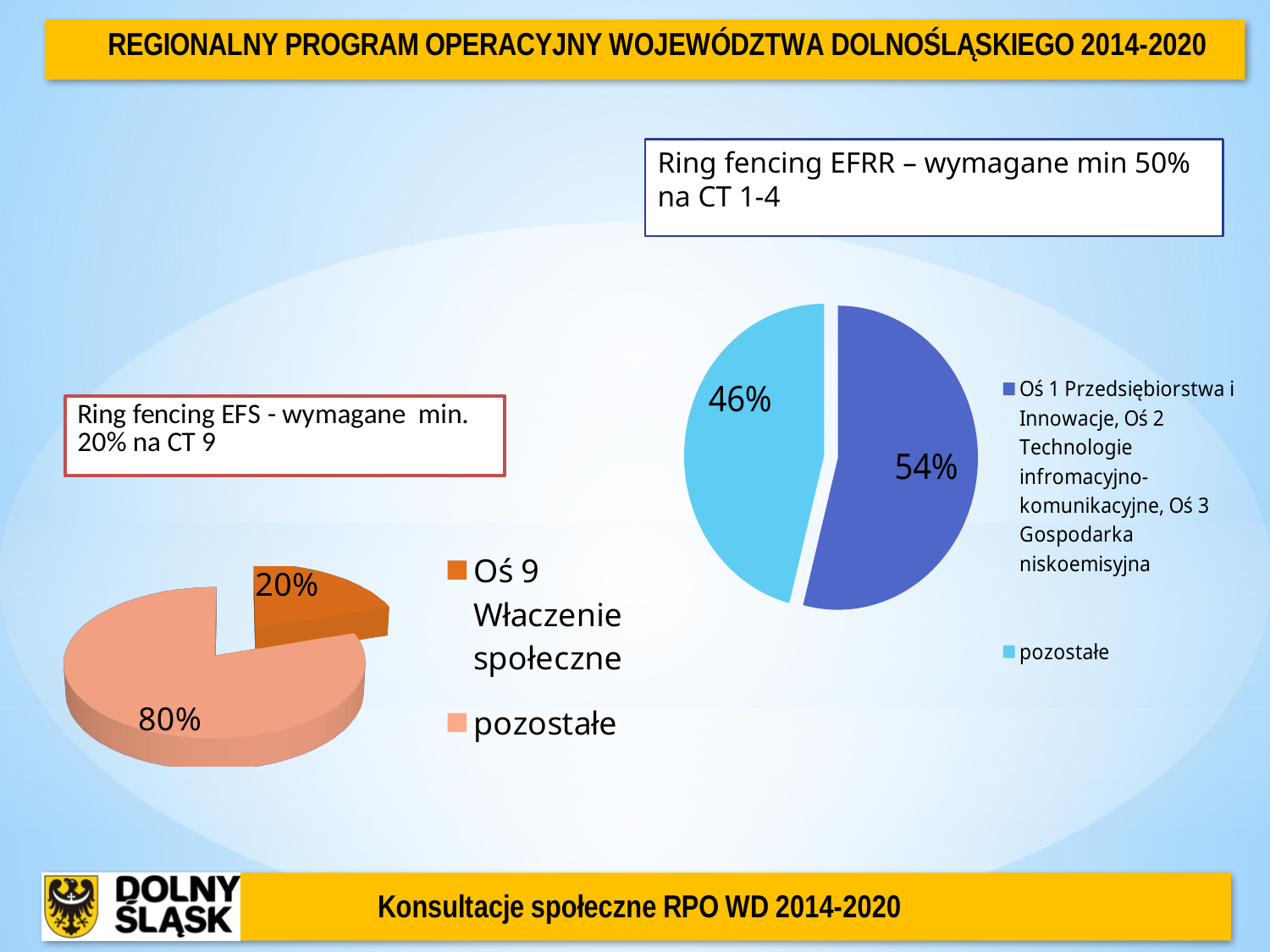
In the pie chart on the left of the slide, what share is labelled for 'Oś 9 Włączenie społeczne'? 20% In the pie chart on the left of the slide, what share is labelled for 'pozostałe'? 80% In the pie chart on the right of the slide, what share is labelled for the slice covering Oś 1, Oś 2 and Oś 3? 54% What type of chart is shown on the right of the slide? Pie chart In the pie chart on the left of the slide, what is the difference in percentage points between the 'pozostałe' slice and the 'Oś 9 Włączenie społeczne' slice? 60 In the pie chart on the right of the slide, which slice is larger: the Oś 1/Oś 2/Oś 3 slice or 'pozostałe'? Oś 1/Oś 2/Oś 3 slice How many slices does the pie chart on the left of the slide have? 2 How many entries does the legend of the pie chart on the right of the slide list? 2 In the pie chart on the right of the slide, what share is labelled for 'pozostałe'? 46% In the pie chart on the right of the slide, what is the difference in percentage points between the two slices? 8 In the pie chart on the left of the slide, which slice is the largest? pozostałe In the pie chart on the right of the slide, which slice is the smallest? pozostałe